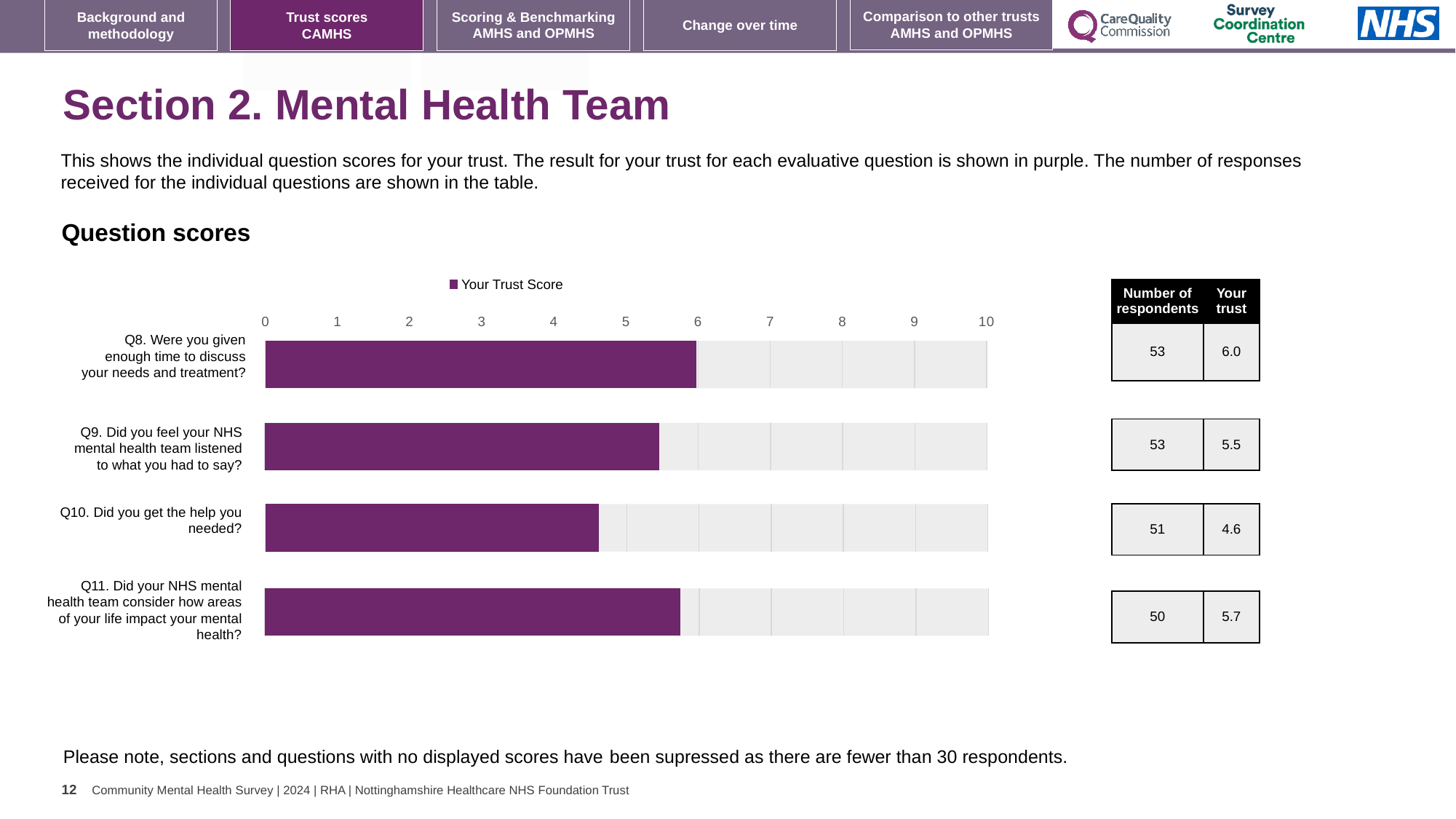
What is the trust score for Q11 (Did your NHS mental health team consider how areas of your life impact your mental health?)? 5.7 What is the trust score for Q8 (Were you given enough time to discuss your needs and treatment?)? 6.0 Which question has the lowest trust score? Q10 Which has the larger trust score, Q9 or Q11? Q11 How many questions are plotted in the chart? 4 What is the single legend entry shown above the chart? Your Trust Score Is the trust score for Q10 greater or less than 5? less What is the difference between the trust scores for Q11 and Q9? 0.2 What type of chart is shown on the slide? Bar chart What is the difference between the trust scores for Q8 and Q10? 1.4 What is the trust score for Q10 (Did you get the help you needed?)? 4.6 Which question has the highest trust score? Q8